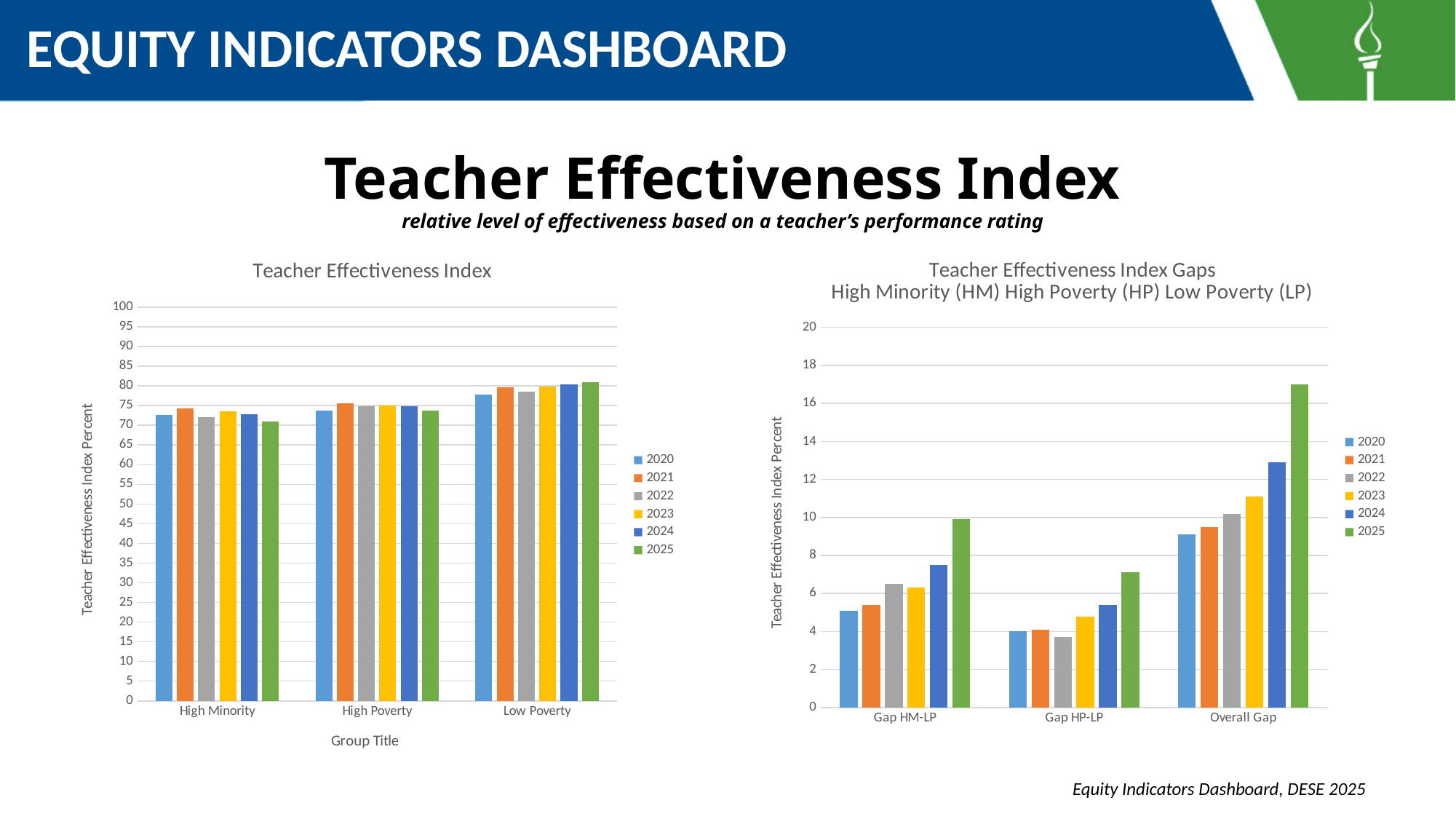
How many series does the legend of the right chart "Teacher Effectiveness Index Gaps" list? 6 What is the y-axis label of the left chart "Teacher Effectiveness Index"? Teacher Effectiveness Index Percent In the right chart "Teacher Effectiveness Index Gaps", do the Overall Gap values rise or fall from 2020 to 2025? rise What kind of chart is the left chart titled "Teacher Effectiveness Index"? bar chart In the right chart "Teacher Effectiveness Index Gaps", which is larger for 2025: Gap HM-LP or Gap HP-LP? Gap HM-LP In the left chart "Teacher Effectiveness Index", which group has the highest values across all years? Low Poverty In the right chart "Teacher Effectiveness Index Gaps", is the 2025 Overall Gap greater or less than 16? greater In the left chart "Teacher Effectiveness Index", is the 2020 value for High Minority greater or less than 70? greater In the left chart "Teacher Effectiveness Index", is the 2025 value for High Poverty greater or less than 75? less How many categories are shown on the x axis of the left chart "Teacher Effectiveness Index"? 3 In the right chart "Teacher Effectiveness Index Gaps", which year has the highest Overall Gap? 2025